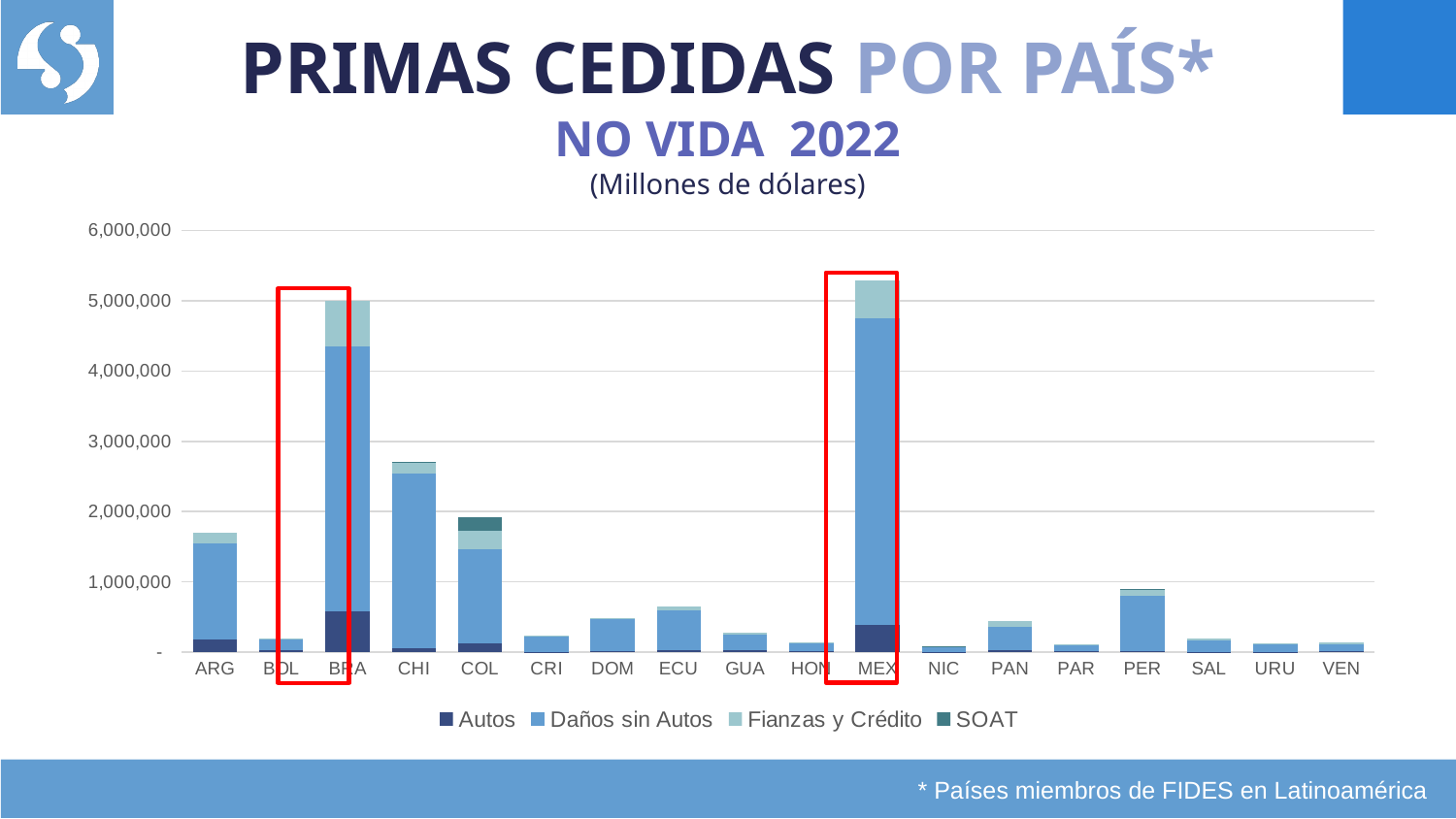
Which has a larger total, CHI or COL? CHI Which country has the highest total of primas cedidas in the chart? MEX Is the total value for ARG greater or less than 2,000,000? less Which has a larger total, ARG or PER? ARG What unit is stated under the chart title? Millones de dólares Which series in the legend is shown in the darkest blue colour? Autos How many series does the legend list? 4 Is the total value for CHI greater or less than 2,000,000? greater How many countries are shown on the x axis of the chart? 18 What kind of chart is shown on the slide? Stacked bar chart Is the total value for DOM greater or less than 1,000,000? less